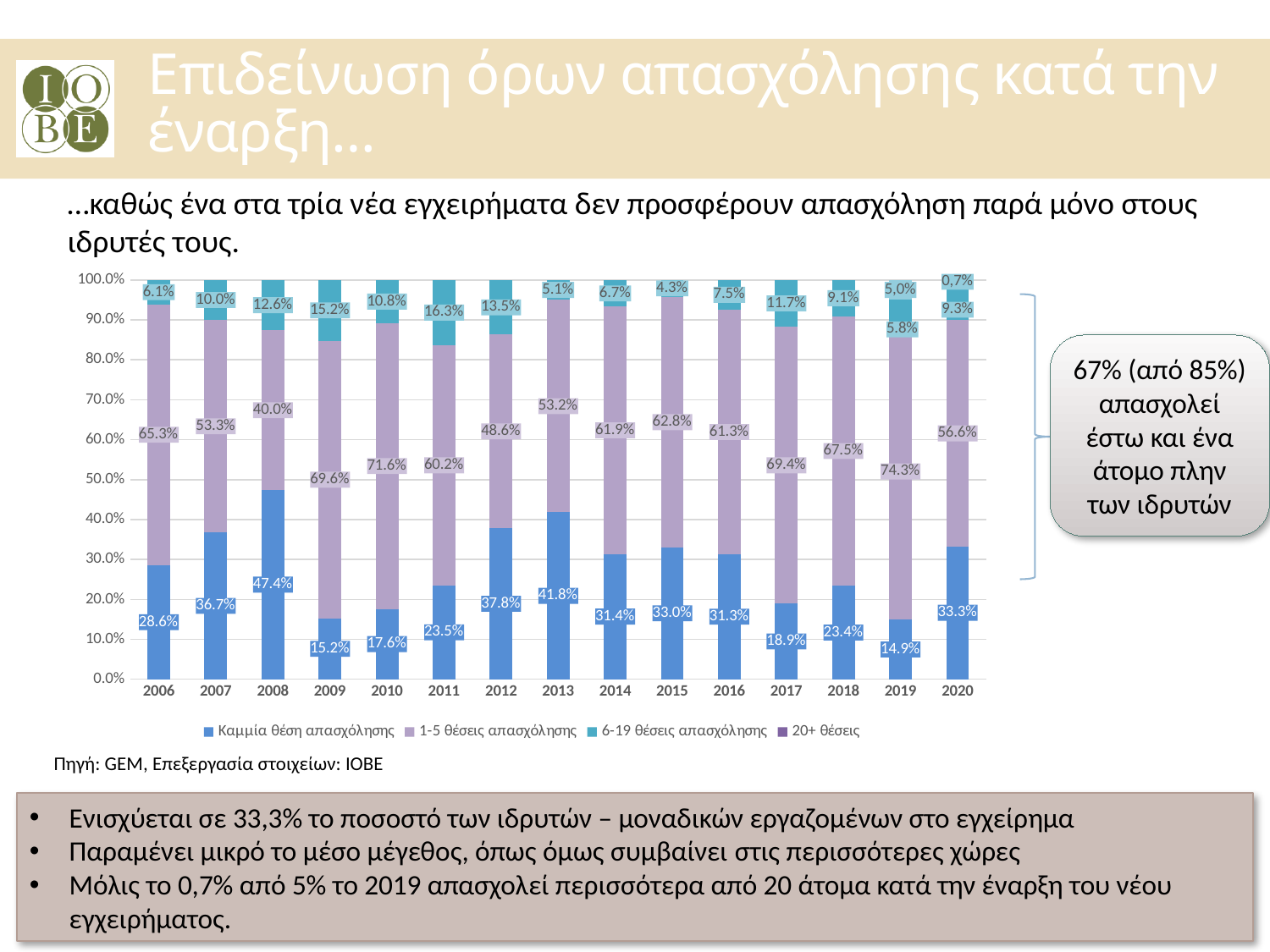
What is the difference between the 'Καμμία θέση απασχόλησης' values for 2020 and 2019? 18.4% In which year is the value for 'Καμμία θέση απασχόλησης' highest? 2008 How many series does the legend list? 4 What is the first series listed in the legend? Καμμία θέση απασχόλησης How many years are shown on the x axis? 15 What is the value for '20+ θέσεις' in 2020? 0,7% What is the value for 'Καμμία θέση απασχόλησης' in 2020? 33.3% In which year is the value for 'Καμμία θέση απασχόλησης' lowest? 2019 What kind of chart is shown on the slide? stacked bar chart What is the value for '6-19 θέσεις απασχόλησης' in 2011? 16.3% Which year has the larger value for '1-5 θέσεις απασχόλησης', 2010 or 2012? 2010 What is the value for '1-5 θέσεις απασχόλησης' in 2019? 74.3%